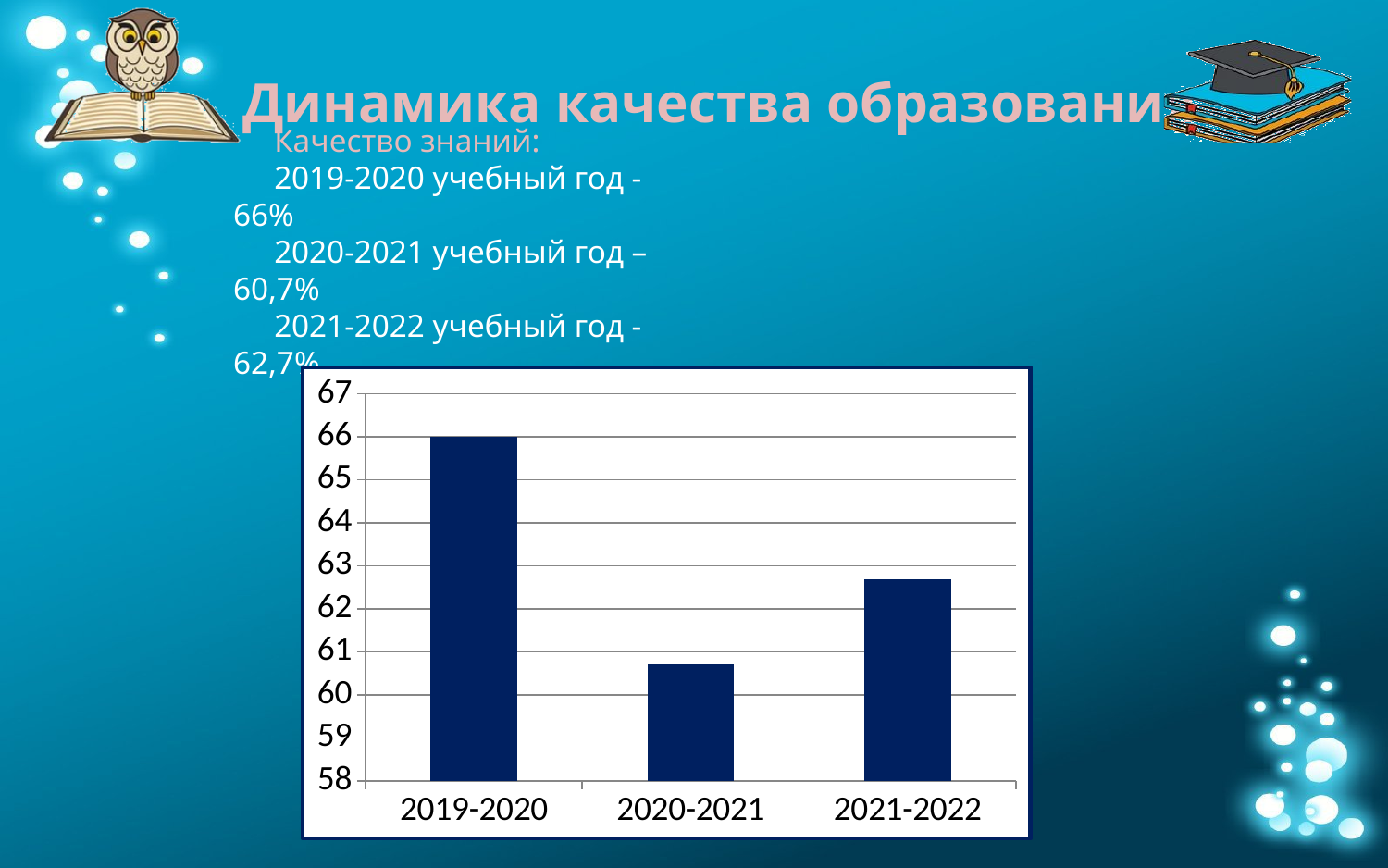
According to the slide text, what was the quality of knowledge in the 2021-2022 school year? 62,7% Which school year has the highest bar in the chart? 2019-2020 Is the value for 2020-2021 greater or less than 61? less What is the value for 2019-2020 in the chart? 66 By how much does the 2019-2020 value exceed the 2020-2021 value, using the figures printed on the slide? 5,3% How many bars (categories) does the chart show? 3 Which is larger, the value for 2021-2022 or the value for 2020-2021? 2021-2022 According to the slide text, what was the quality of knowledge in the 2020-2021 school year? 60,7% What kind of chart is shown on the slide? bar chart What is the title of the slide containing the chart? Динамика качества образования Is the value for 2021-2022 greater or less than 62? greater Which school year has the lowest bar in the chart? 2020-2021